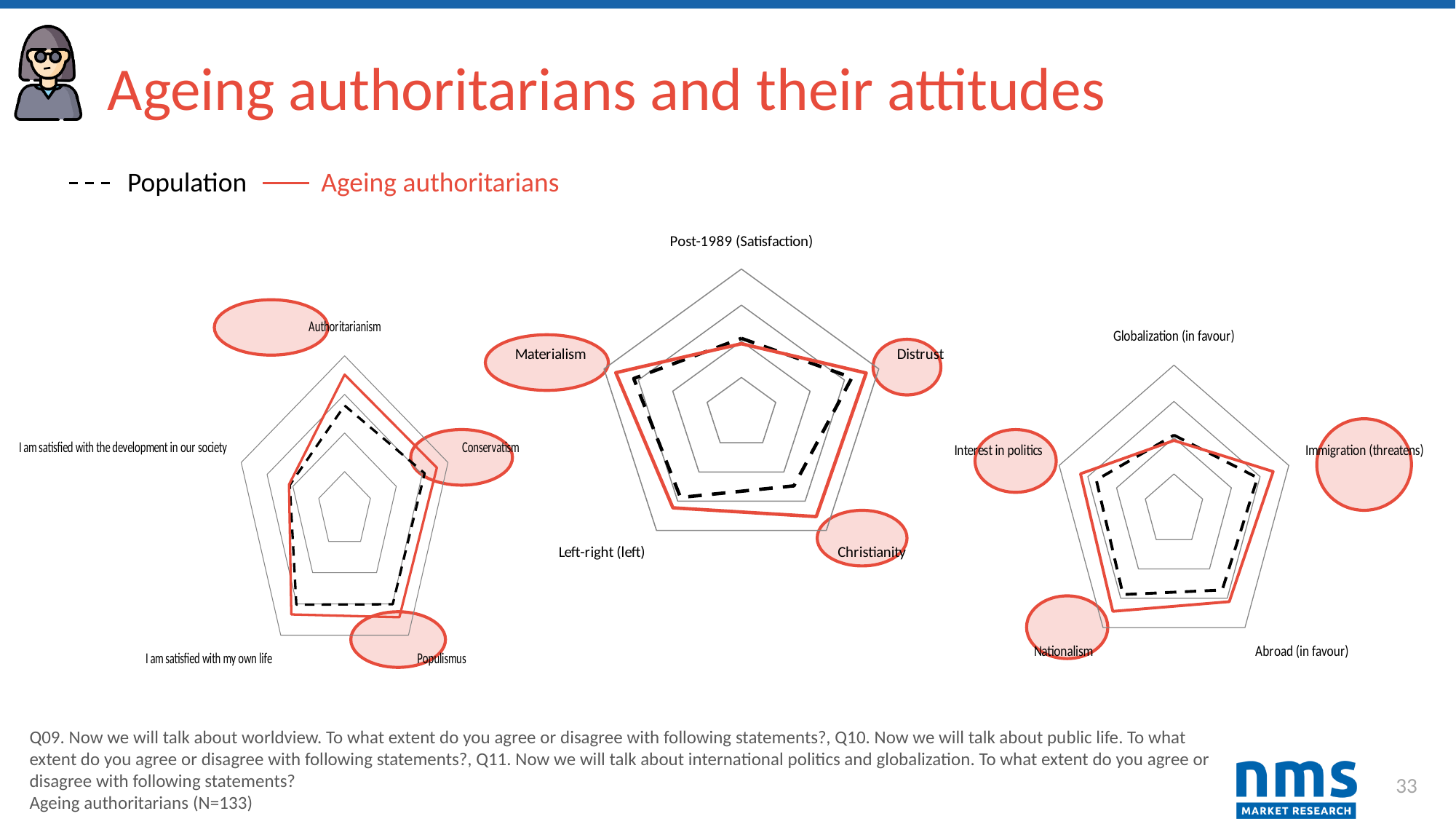
In the left chart, which series has the higher value for Authoritarianism, Population or Ageing authoritarians? Ageing authoritarians In the right chart, which series has the higher value for Nationalism, Population or Ageing authoritarians? Ageing authoritarians How many series does the legend list? 2 In the right chart, which series has the higher value for Immigration (threatens), Population or Ageing authoritarians? Ageing authoritarians In the middle chart, how many axes (categories) are there? 5 Which two series are shown in the legend? Population and Ageing authoritarians How many radar charts are on the slide? 3 In the left chart, how many axes (categories) are there? 5 What kind of chart is used on this slide? Radar chart